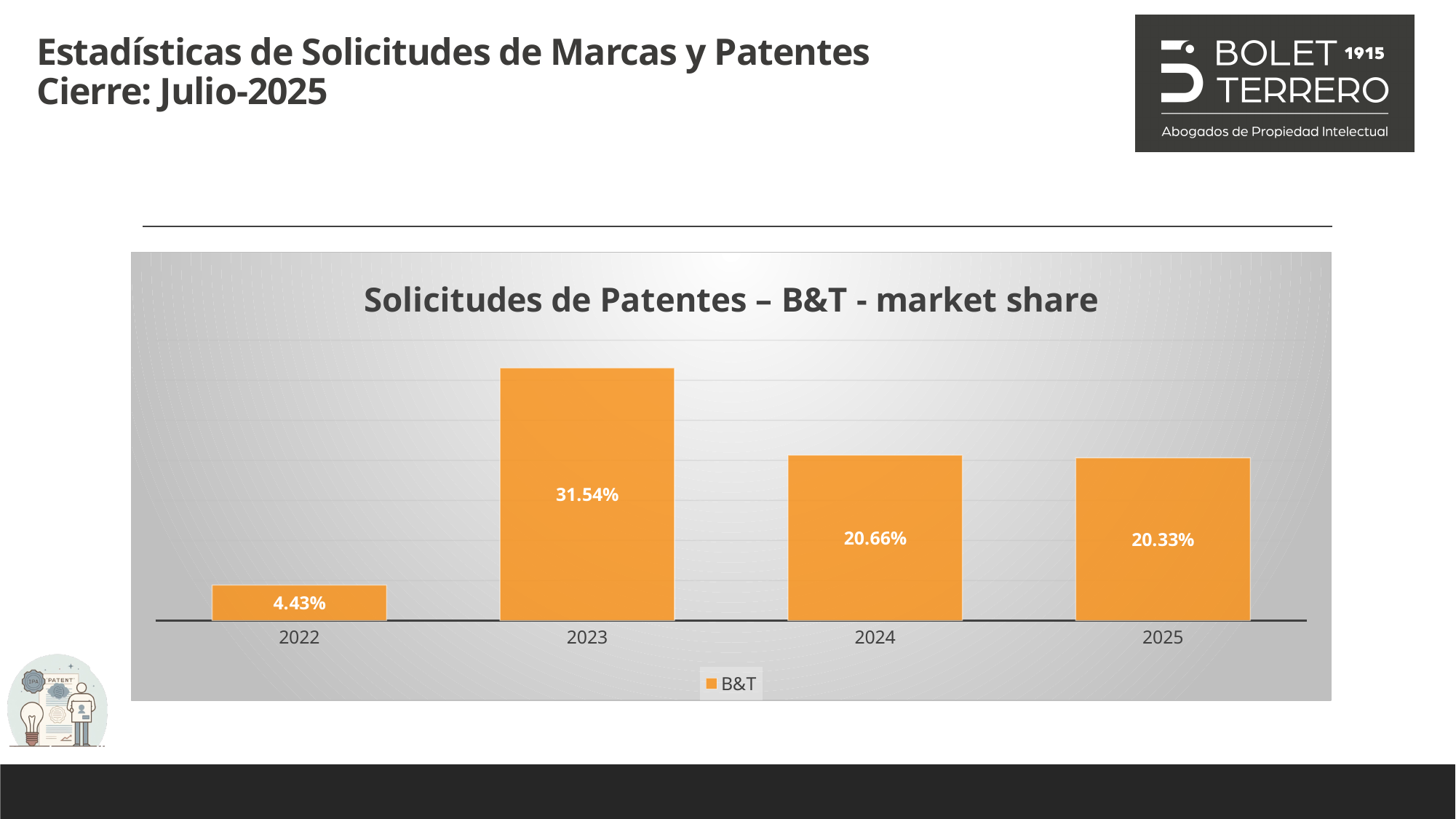
What is the B&T market share value for 2022? 4.43% What is the B&T market share value for 2025? 20.33% How many series does the legend list? 1 What is the difference between the B&T market share in 2024 and in 2025? 0.33% What is the difference between the B&T market share in 2023 and in 2022? 27.11% Which year has the highest B&T market share? 2023 Which year has the lowest B&T market share? 2022 What is the B&T market share value for 2024? 20.66% What kind of chart is shown on the slide? Bar chart How many years are shown on the x axis of the chart? 4 Which is larger, the B&T market share in 2023 or in 2024? 2023 What is the B&T market share value for 2023? 31.54%